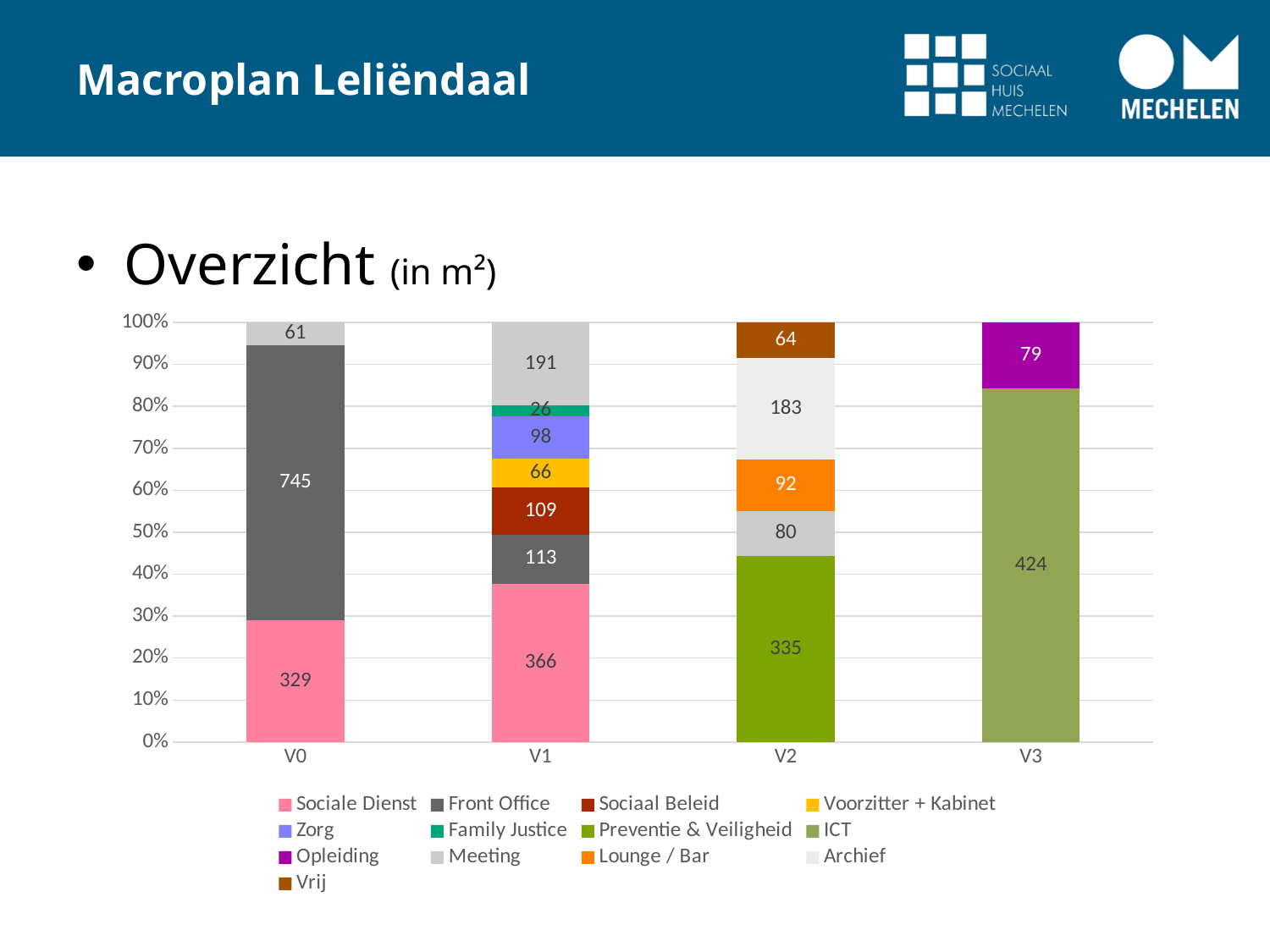
What is the total of the stacked bar for V0? 1135 Which category has the largest Front Office value? V0 What is the value for Front Office in V0? 745 What is the value for Archief in V2? 183 What type of chart is shown on the slide? stacked bar chart What is the difference between Sociale Dienst in V1 and Sociale Dienst in V0? 37 Which is larger: Meeting in V1 or Meeting in V2? Meeting in V1 What is the total of the stacked bar for V3? 503 What is the value for ICT in V3? 424 How many categories are shown on the x axis of the chart? 4 How many series does the chart legend list? 13 What is the value for Sociale Dienst in V1? 366